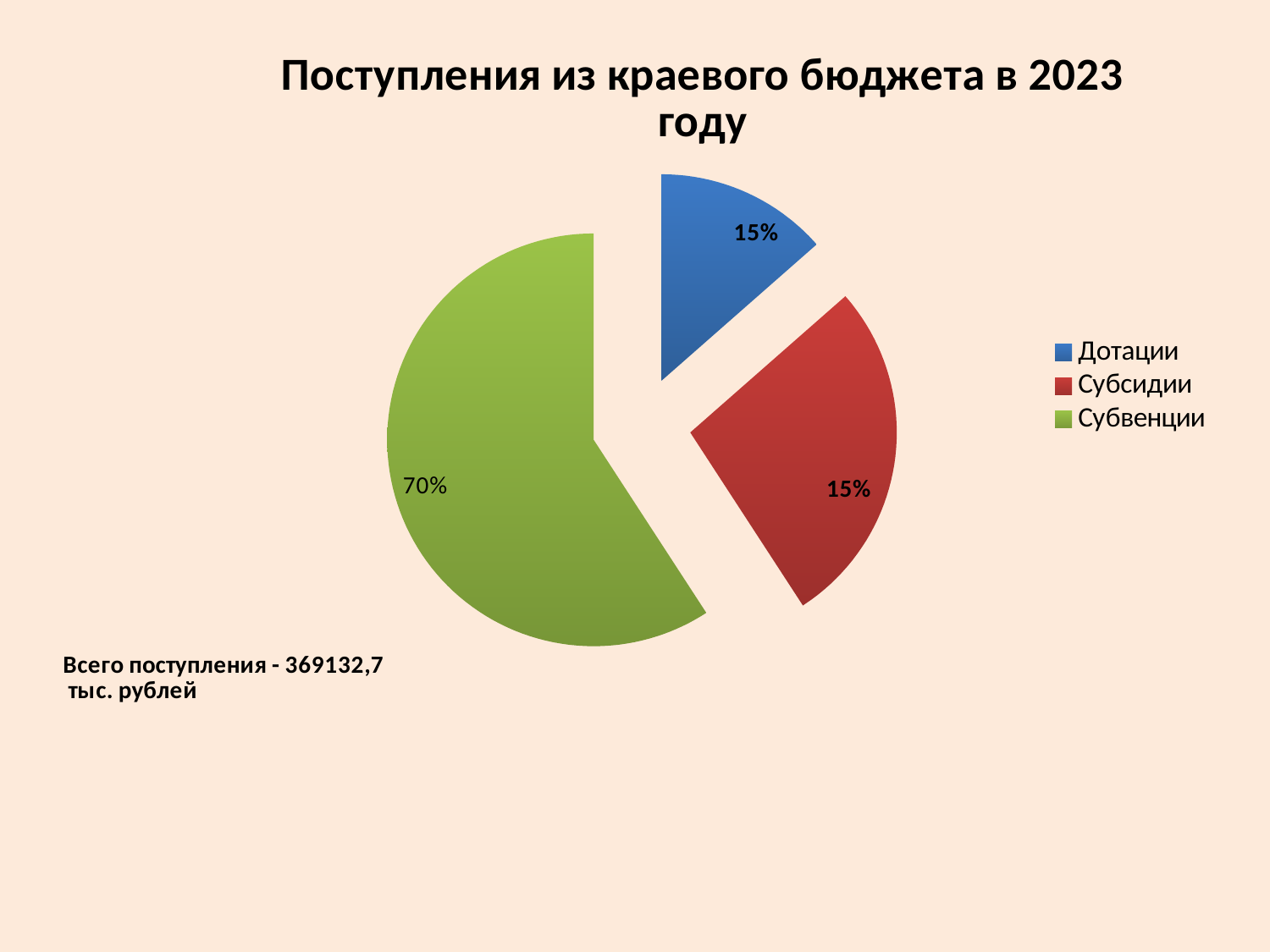
How many slices does the pie chart have? 3 Which is larger, the slice for Субвенции or the slice for Субсидии? Субвенции What kind of chart is shown on the slide? pie chart What share of the pie does Субвенции have? 70% What is the difference in percentage points between Субвенции and Дотации? 55 What share of the pie does Дотации have? 15% Which category has the largest slice of the pie? Субвенции What is the title of the chart? Поступления из краевого бюджета в 2023 году How many entries does the legend list? 3 What colour is the slice for Субсидии? red What is the combined share of Дотации and Субсидии? 30% What share of the pie does Субсидии have? 15%